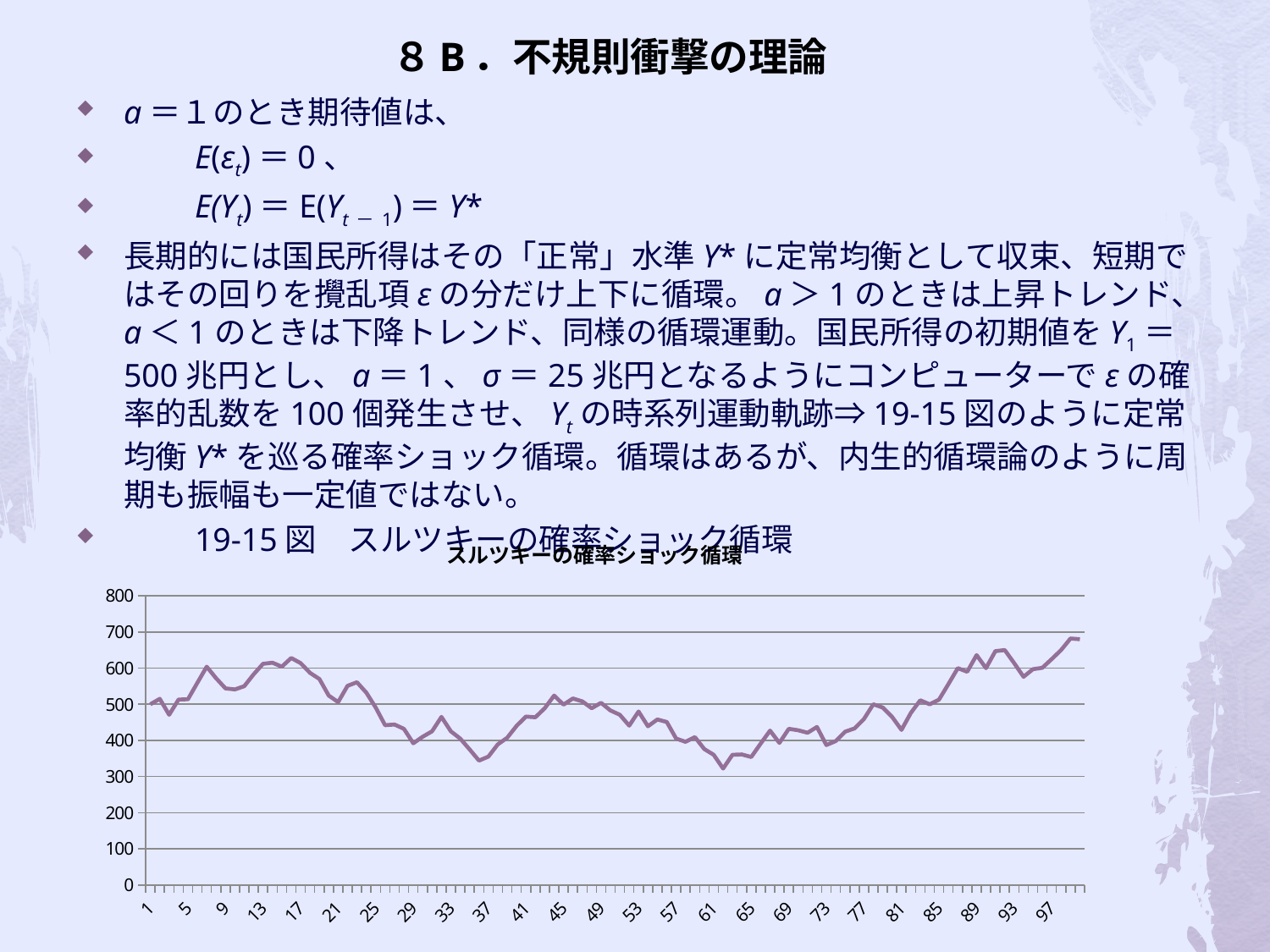
Is the value at point 63 greater or less than 400? less How many data series are plotted on the chart? 1 Is the value at point 89 greater or less than 600? greater Is the value at point 37 greater or less than 400? less What kind of chart is shown on the slide? line chart What is the title of the chart? スルツキーの確率ショック循環 Does the series end at a higher or lower value than it starts? higher What is the highest value shown on the chart's vertical axis? 800